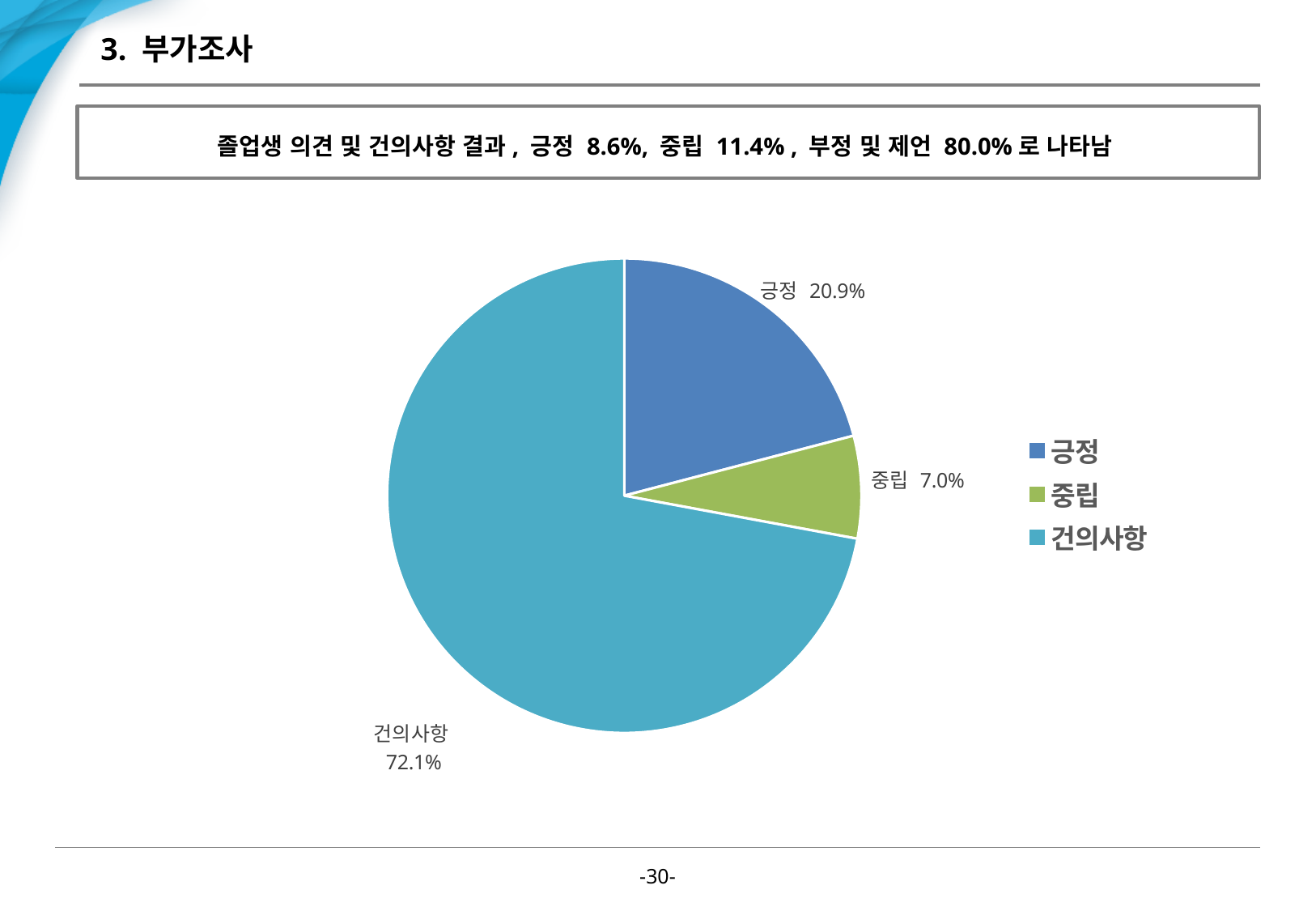
How many entries does the legend list? 3 What colour is the 건의사항 slice in the pie chart? teal blue How many slices does the pie chart have? 3 What is the difference in percentage points between 건의사항 and 긍정? 51.2 What is the difference in percentage points between 긍정 and 중립? 13.9 Which is larger, the slice for 긍정 or the slice for 중립? 긍정 What type of chart is shown on the slide? pie chart What share of the pie does 긍정 represent? 20.9% Which category has the smallest slice of the pie? 중립 Which category has the largest slice of the pie? 건의사항 What share of the pie does 중립 represent? 7.0% What share of the pie does 건의사항 represent? 72.1%